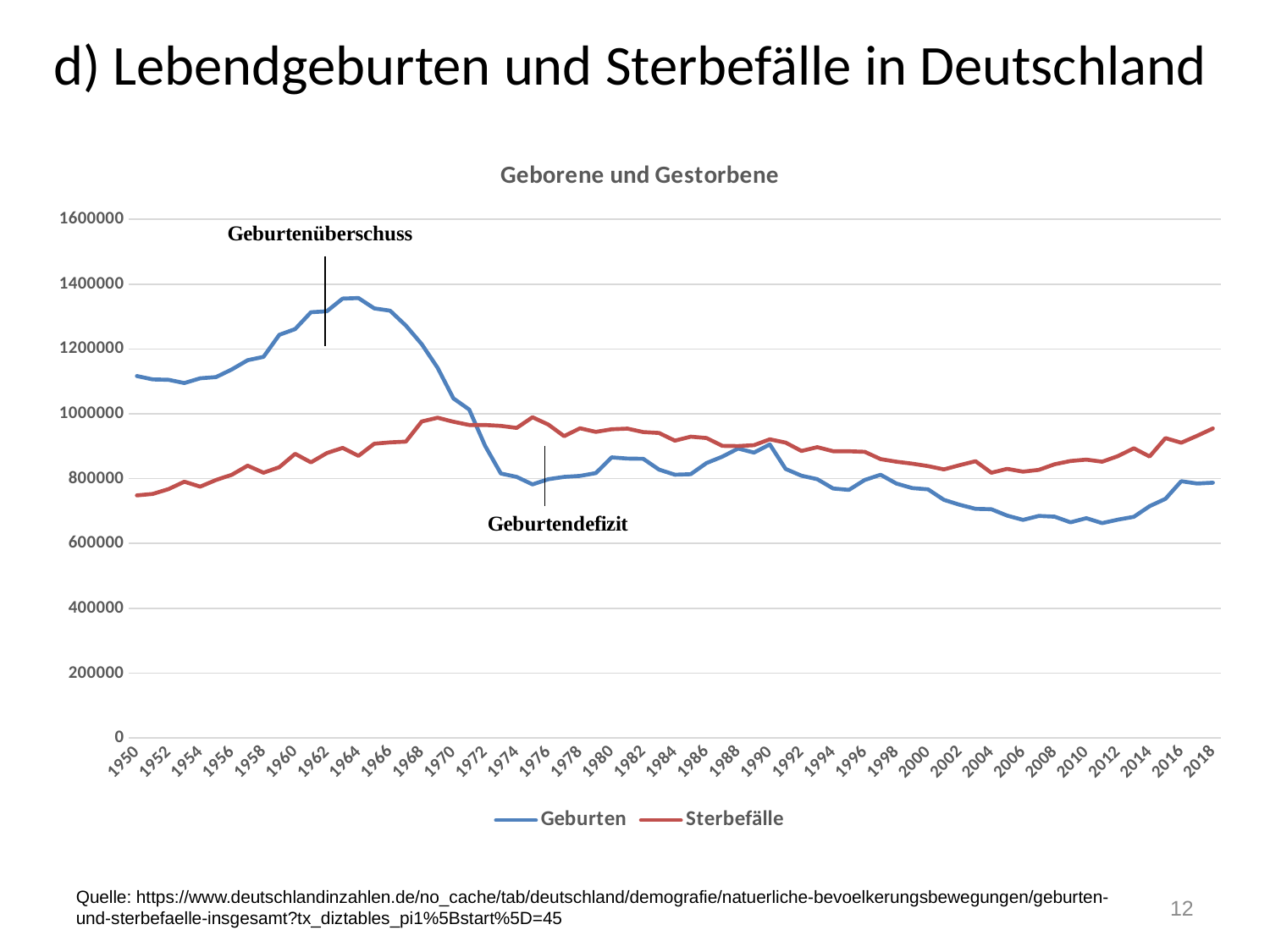
Which colour is used for the Sterbefälle series? red What kind of chart is shown on the slide? line chart Is the value for Sterbefälle in 2018 greater or less than 800000? greater Is the value for Geburten in 1950 greater or less than 1000000? greater In 2010, which series has the larger value, Geburten or Sterbefälle? Sterbefälle Is the value for Geburten in 1964 greater or less than 1200000? greater In 1964, which series has the larger value, Geburten or Sterbefälle? Geburten Do the Geburten values rise or fall between 1964 and 1975? fall How many series does the legend list? 2 What is the title of the chart? Geborene und Gestorbene